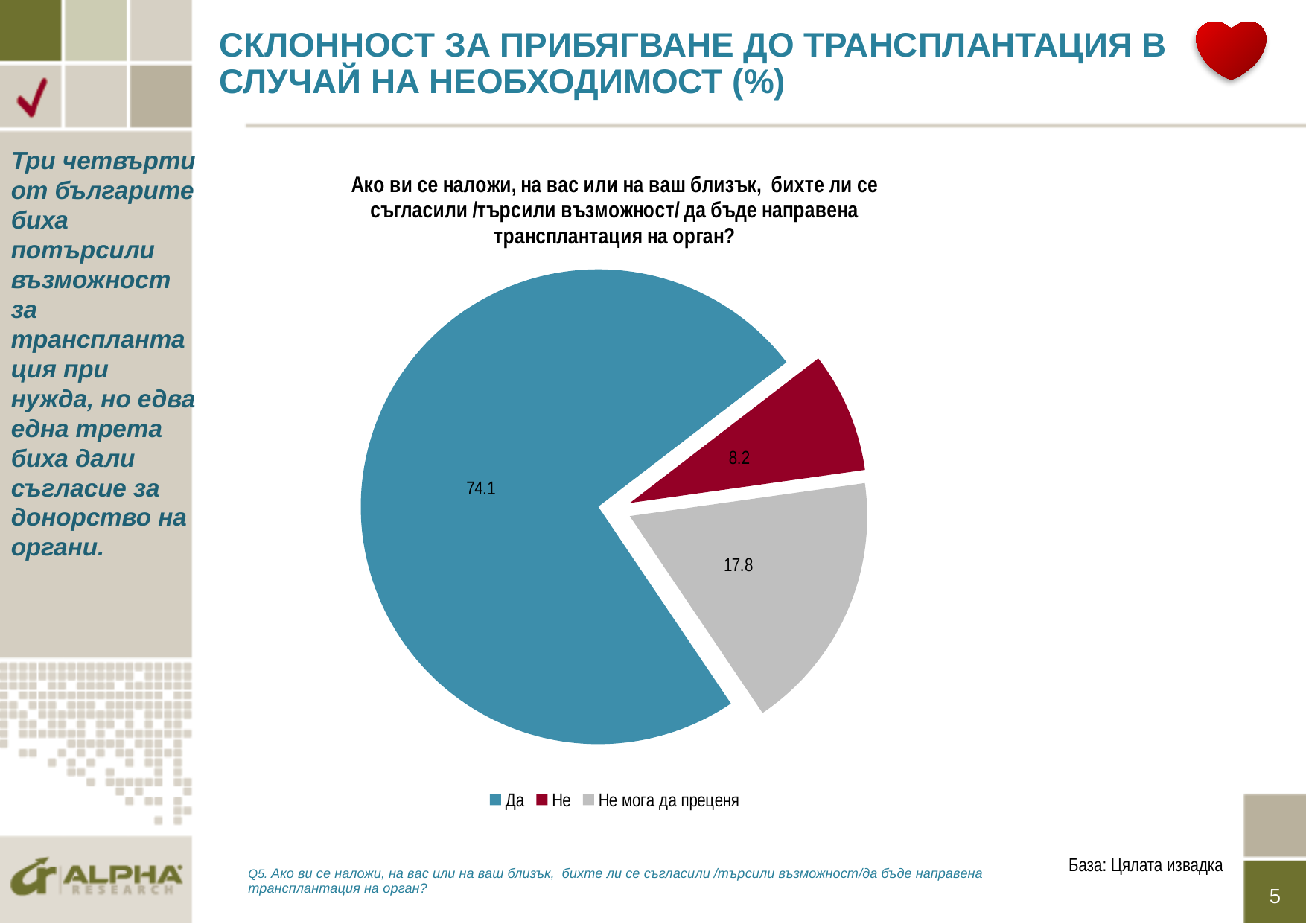
How many entries does the legend list? 3 What is the value for "Да" in the pie chart? 74.1 What is the difference between the values for "Не мога да преценя" and "Не"? 9.6 Which category has the largest slice in the pie chart? Да What is the difference between the values for "Да" and "Не мога да преценя"? 56.3 What is the value for "Не" in the pie chart? 8.2 What is the value for "Не мога да преценя" in the pie chart? 17.8 Which is larger, the value for "Не" or the value for "Не мога да преценя"? Не мога да преценя What kind of chart is shown on the slide? pie chart How many categories does the pie chart show? 3 Which category has the smallest slice in the pie chart? Не What colour is the slice for "Не" in the pie chart? dark red